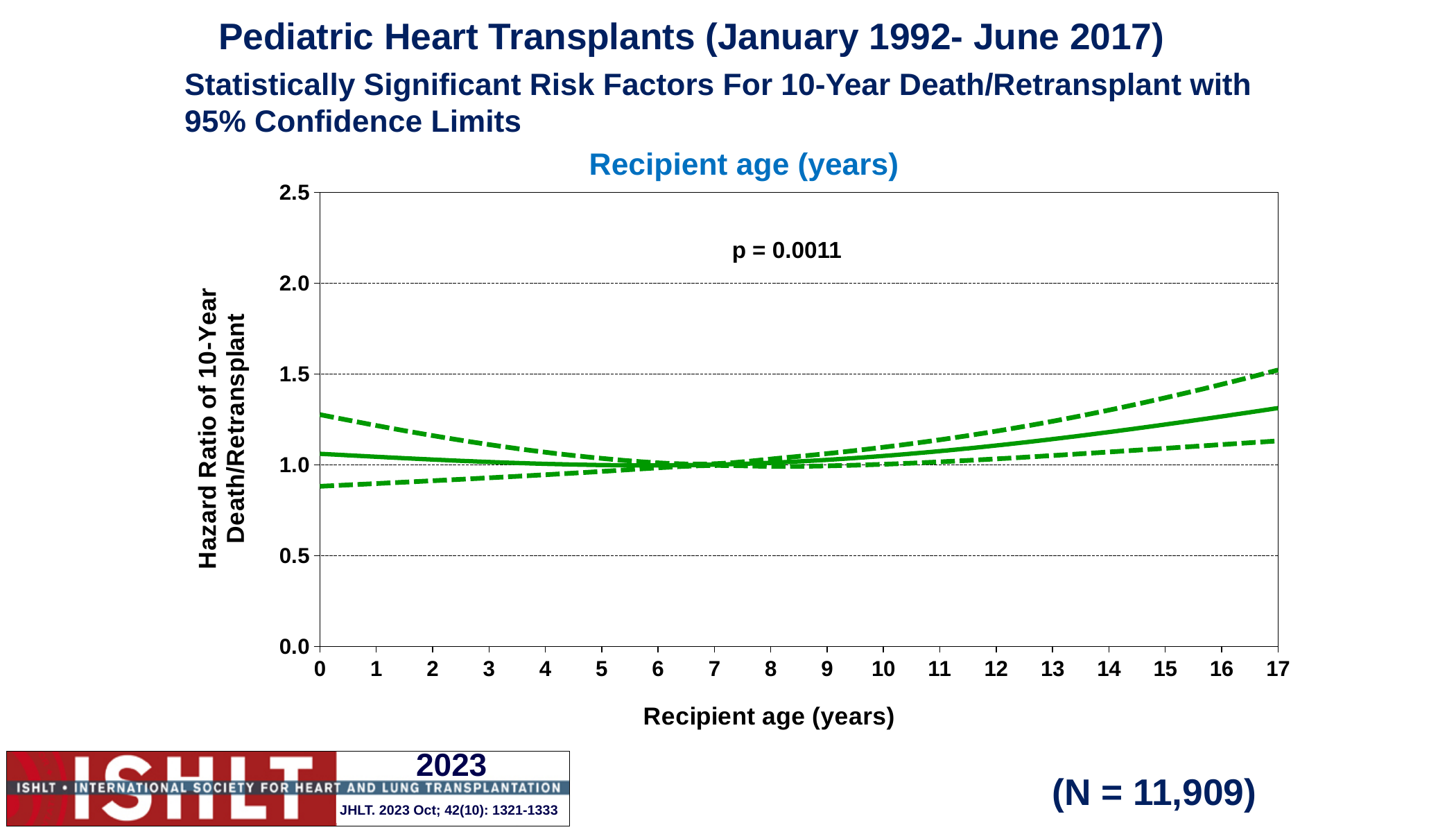
Does the hazard ratio (solid line) rise or fall as recipient age increases from 0 to 6 years? fall How many lines are plotted on the chart? 3 Is the upper confidence limit (upper dashed line) at recipient age 17 greater or less than 2.0? less What p-value is printed on the chart? p = 0.0011 Is the upper confidence limit (upper dashed line) at recipient age 0 greater or less than 1.0? greater Is the hazard ratio (solid line) at recipient age 17 greater or less than 1.0? greater Does the hazard ratio (solid line) rise or fall as recipient age increases from 7 to 17 years? rise What kind of chart is shown on the slide? line chart What is the title printed above the chart in blue? Recipient age (years) What is the highest value shown on the y axis? 2.5